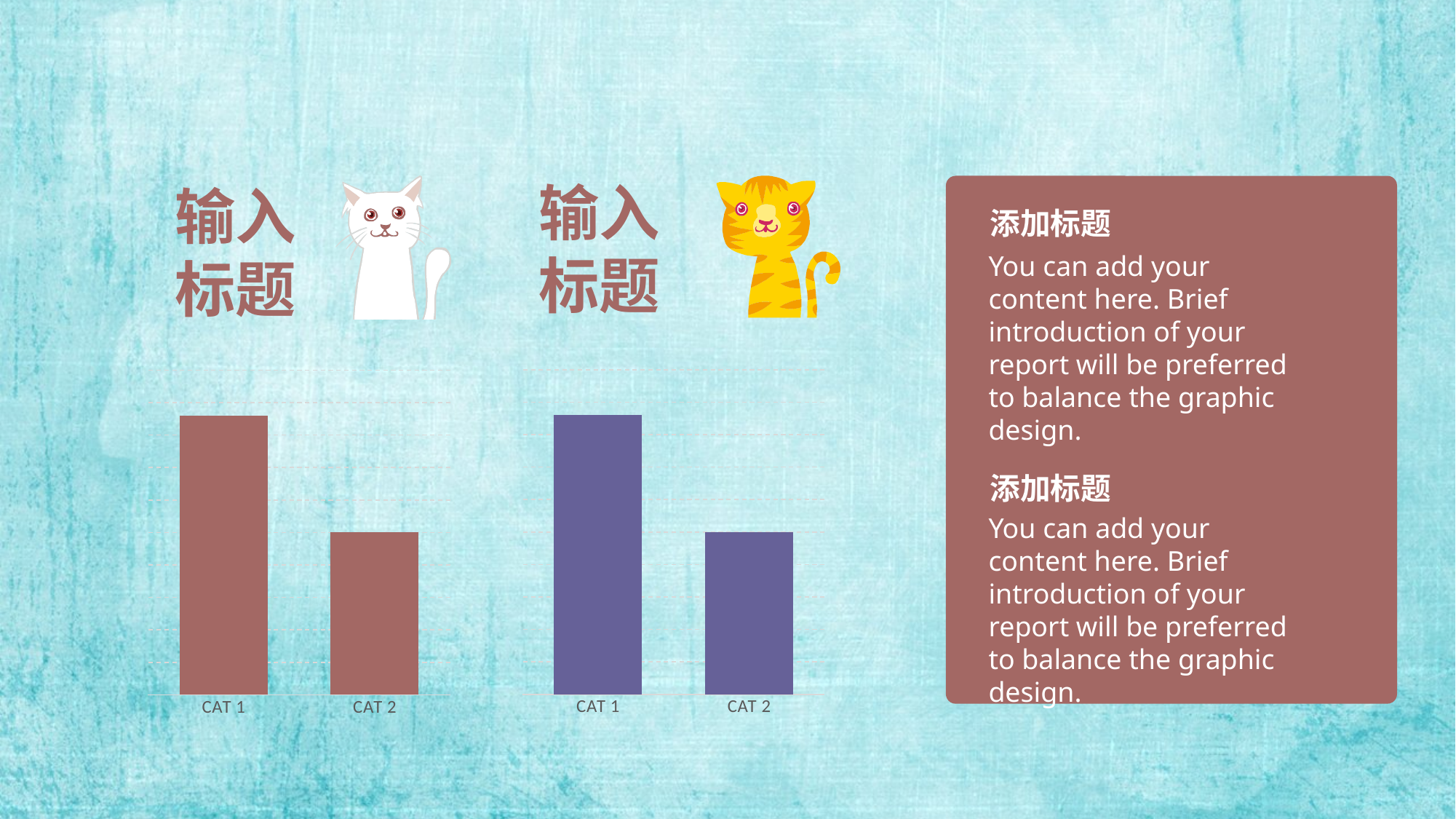
In the left chart, how many categories are shown on the x axis? 2 In the right chart, how many categories are shown on the x axis? 2 In the right chart, which category has the lowest bar? CAT 2 What colour are the bars in the right chart? purple In the left chart, is the bar for CAT 1 taller or shorter than the bar for CAT 2? taller What kind of chart is the right chart on the slide? bar chart In the right chart, which category has the highest bar? CAT 1 In the left chart, which category has the lowest bar? CAT 2 In the right chart, is the bar for CAT 2 taller or shorter than the bar for CAT 1? shorter What kind of chart is the left chart on the slide? bar chart In the left chart, which category has the highest bar? CAT 1 What colour are the bars in the left chart? brown